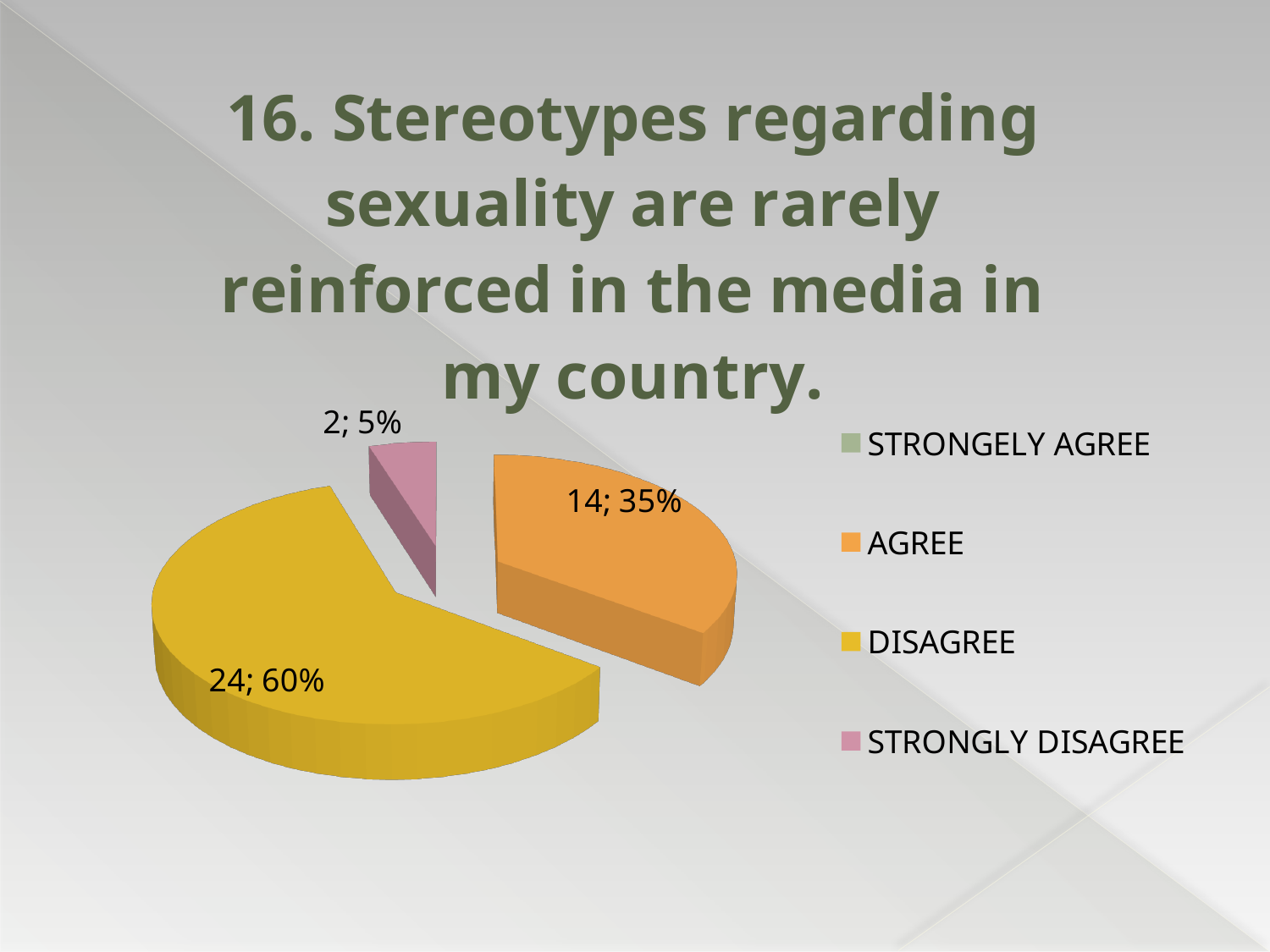
What is the count shown for DISAGREE? 24 What percentage share does DISAGREE have? 60% Which is larger, the count for AGREE or the count for STRONGLY DISAGREE? AGREE What kind of chart is shown on the slide? pie chart What percentage share does AGREE have? 35% What is the difference in count between DISAGREE and AGREE? 10 Which visible slice is the smallest? STRONGLY DISAGREE What colour is the DISAGREE slice? yellow How many slices are visible in the pie chart? 3 What is the count shown for STRONGLY DISAGREE? 2 How many entries does the legend list? 4 Which category has the largest slice? DISAGREE